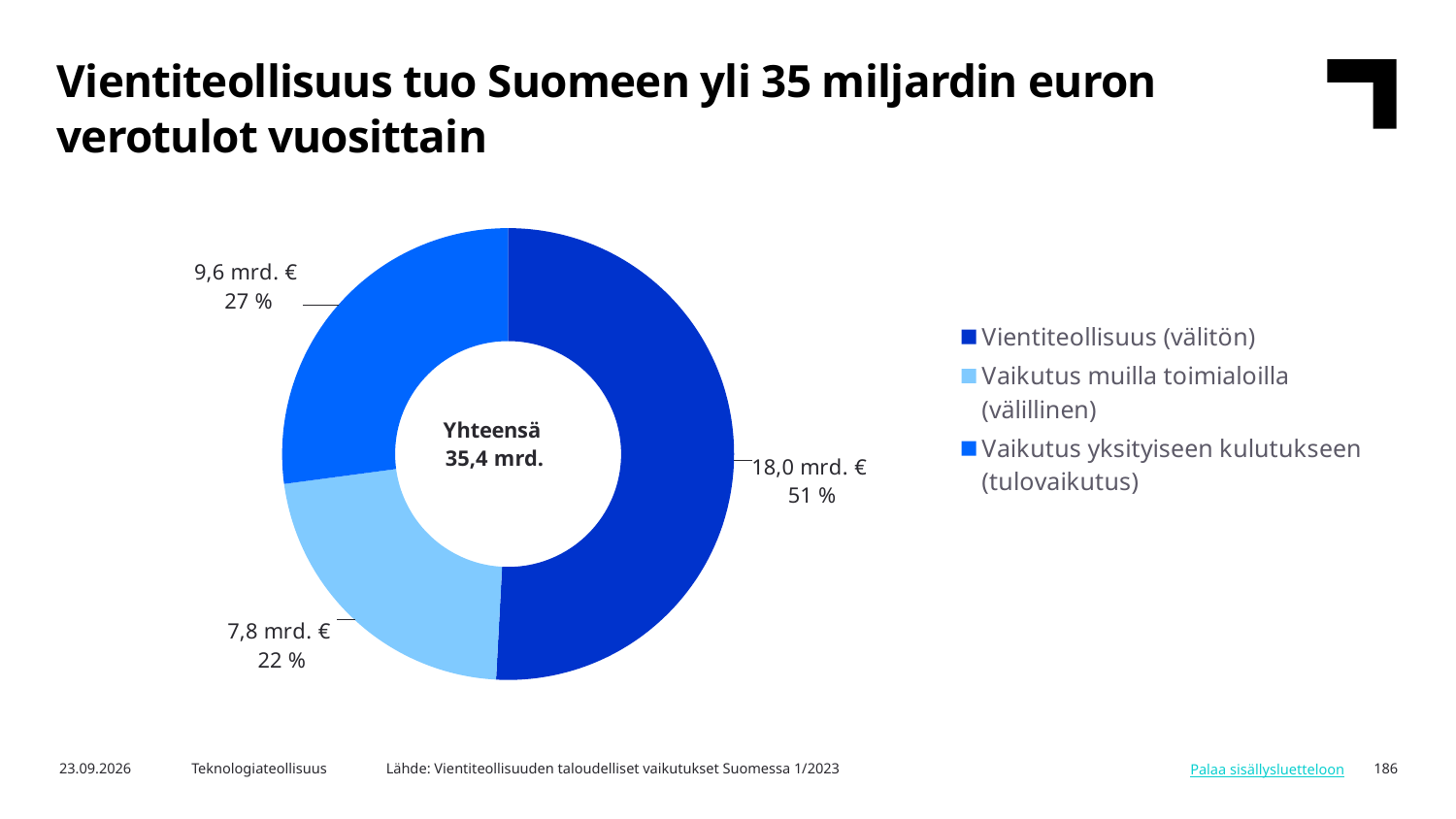
What share of the pie does Vaikutus muilla toimialoilla (välillinen) represent? 22 % What total is printed in the centre of the donut chart? Yhteensä 35,4 mrd. What is the difference between the values for Vientiteollisuus (välitön) and Vaikutus yksityiseen kulutukseen (tulovaikutus)? 8,4 mrd. € How many categories does the chart show? 3 What share of the pie does Vientiteollisuus (välitön) represent? 51 % Which category has the largest slice? Vientiteollisuus (välitön) What is the value for Vaikutus muilla toimialoilla (välillinen)? 7,8 mrd. € What kind of chart is shown on the slide? Pie (donut) chart What is the value for Vientiteollisuus (välitön)? 18,0 mrd. € What is the value for Vaikutus yksityiseen kulutukseen (tulovaikutus)? 9,6 mrd. € Which category has the smallest slice? Vaikutus muilla toimialoilla (välillinen) Which is larger, the value for Vaikutus yksityiseen kulutukseen (tulovaikutus) or Vaikutus muilla toimialoilla (välillinen)? Vaikutus yksityiseen kulutukseen (tulovaikutus)